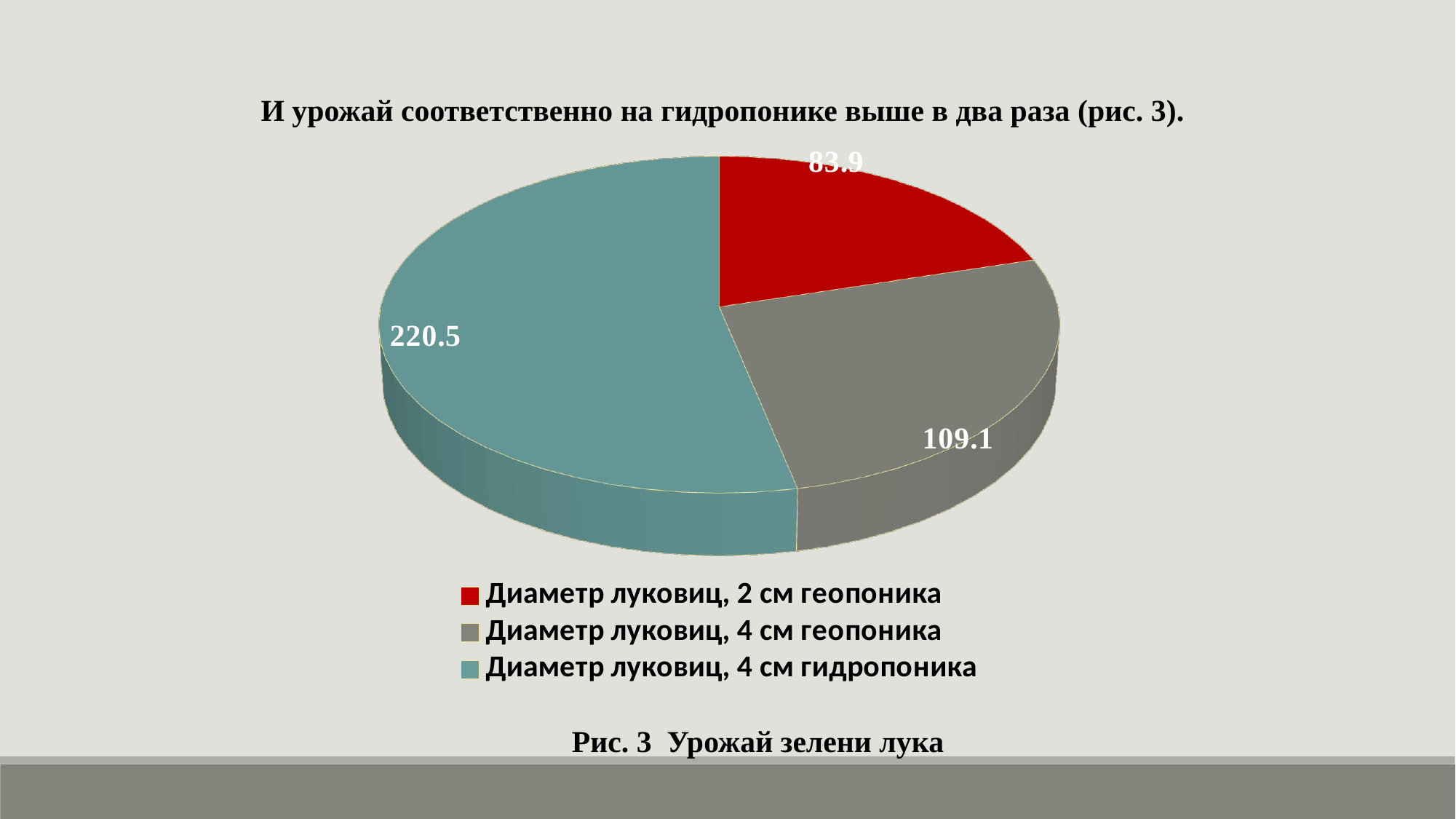
What is the value for "Диаметр луковиц, 4 см геопоника"? 109.1 What is the caption of the figure below the chart? Рис. 3 Урожай зелени лука What is the total of all slices in the pie chart? 413.5 Which category has the largest slice of the pie? Диаметр луковиц, 4 см гидропоника What is the value for "Диаметр луковиц, 2 см геопоника"? 83.9 What is the difference between the values for "Диаметр луковиц, 4 см геопоника" and "Диаметр луковиц, 2 см геопоника"? 25.2 Which is larger: the value for "Диаметр луковиц, 4 см геопоника" or for "Диаметр луковиц, 2 см геопоника"? Диаметр луковиц, 4 см геопоника How many slices does the pie chart have? 3 What type of chart is shown on the slide? Pie chart Which category has the smallest slice of the pie? Диаметр луковиц, 2 см геопоника What is the value for "Диаметр луковиц, 4 см гидропоника"? 220.5 What is the difference between the values for "Диаметр луковиц, 4 см гидропоника" and "Диаметр луковиц, 4 см геопоника"? 111.4